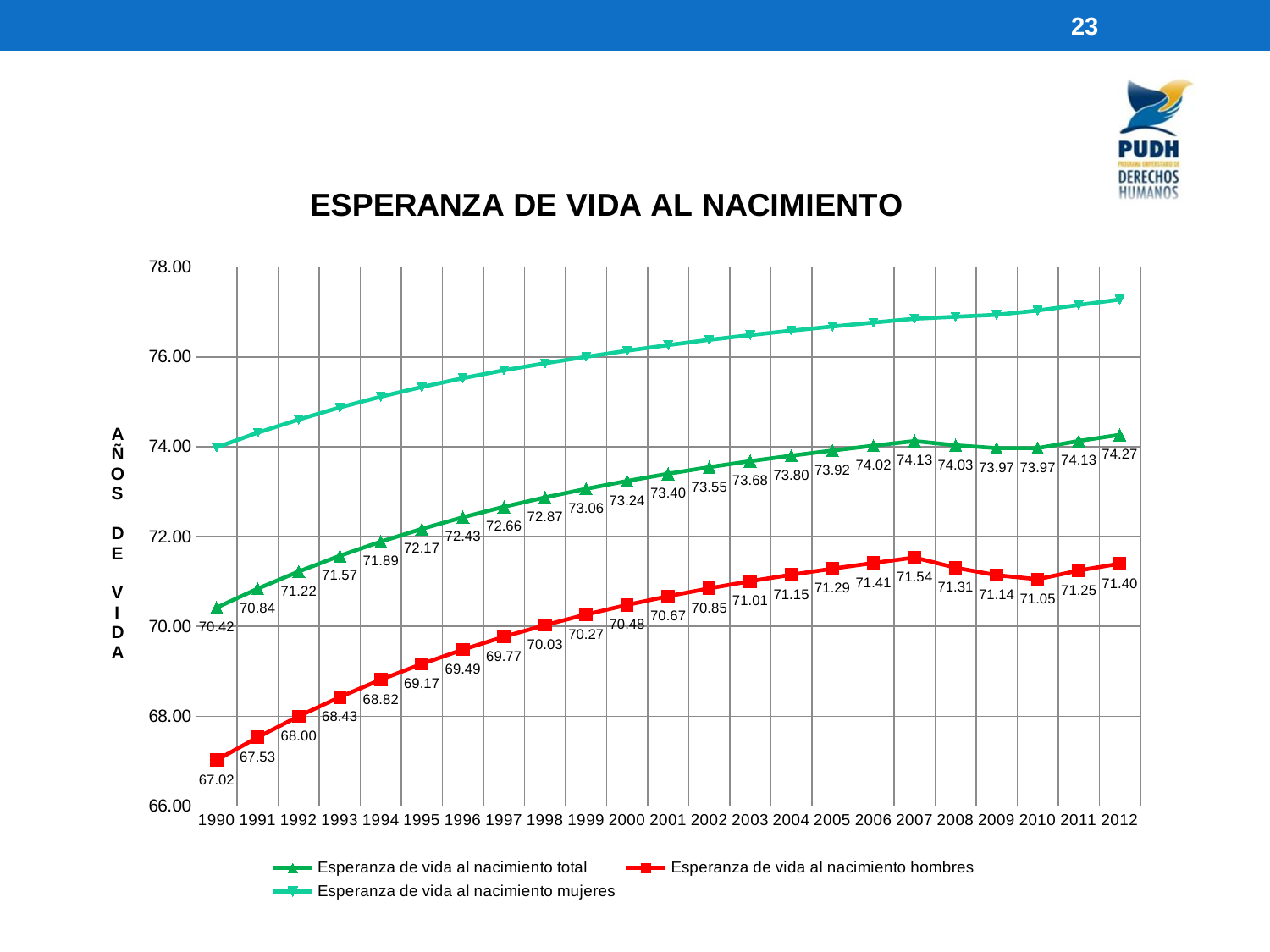
In which year is 'Esperanza de vida al nacimiento hombres' highest? 2007 How many years are plotted along the x axis? 23 What is the difference between the 'Esperanza de vida al nacimiento total' values for 2012 and 1990? 3.85 What is the value of 'Esperanza de vida al nacimiento total' in 2012? 74.27 In which year is 'Esperanza de vida al nacimiento total' lowest? 1990 What is the value of 'Esperanza de vida al nacimiento hombres' in 1990? 67.02 Is the value for 'Esperanza de vida al nacimiento mujeres' in 2012 greater or less than 76.00? greater How many series does the legend list? 3 What is the title of the chart? ESPERANZA DE VIDA AL NACIMIENTO Does 'Esperanza de vida al nacimiento hombres' rise or fall from 1990 to 2007? rise What kind of chart is shown on the slide? line chart Which year has the larger value for 'Esperanza de vida al nacimiento hombres', 2008 or 2009? 2008